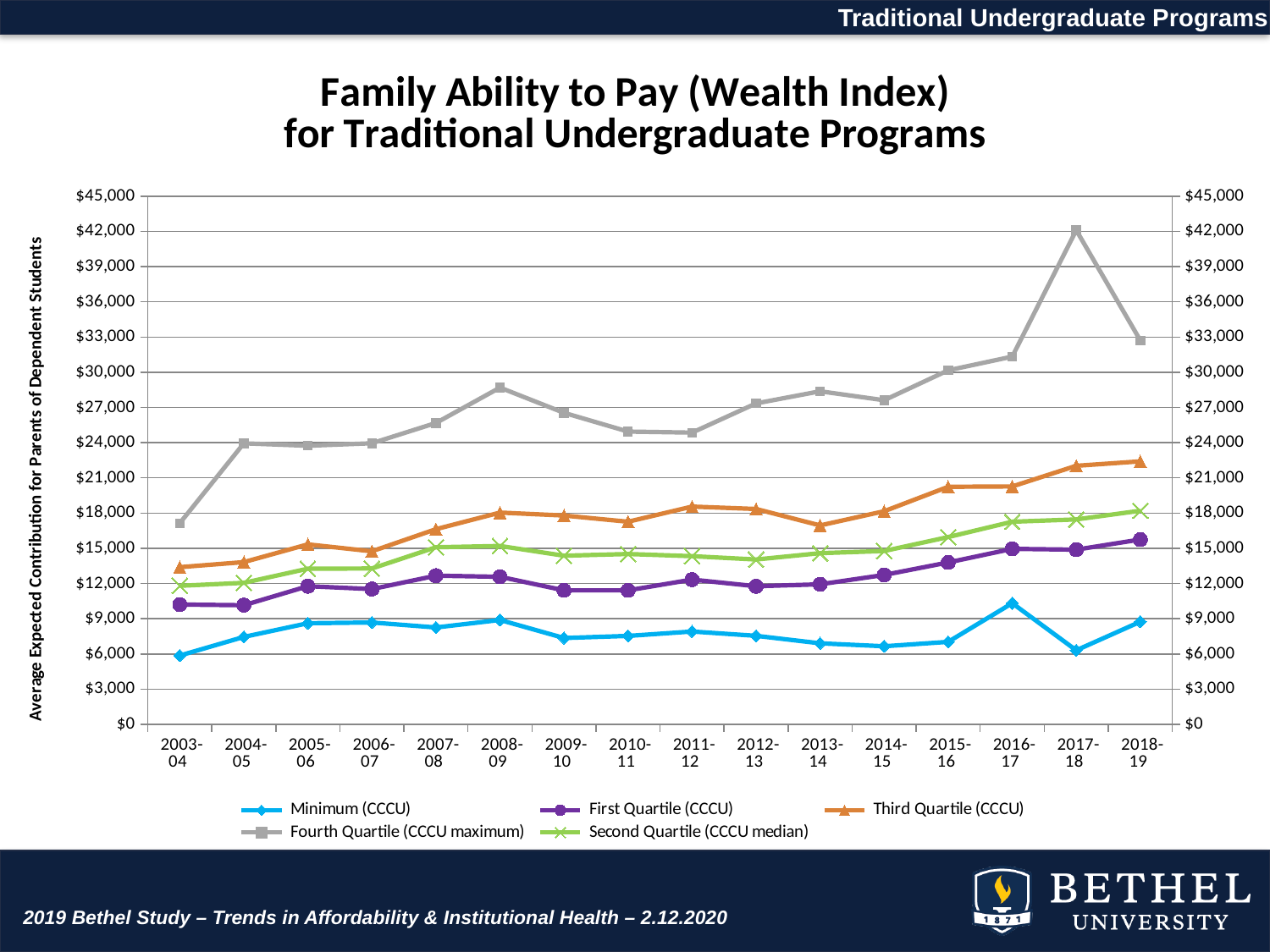
How many series does the legend list? 5 How many academic years are plotted along the x axis? 16 Is the value for Minimum (CCCU) in 2003-04 greater or less than $9,000? less In which year does the Fourth Quartile (CCCU maximum) series reach its highest value? 2017-18 What is the title of the vertical axis? Average Expected Contribution for Parents of Dependent Students What kind of chart is shown on the slide? line chart In which year is the Fourth Quartile (CCCU maximum) series at its lowest value? 2003-04 Is the value for Fourth Quartile (CCCU maximum) in 2017-18 greater or less than $39,000? greater Is the value for Third Quartile (CCCU) in 2018-19 greater or less than $21,000? greater Does the Third Quartile (CCCU) series rise or fall from 2013-14 to 2018-19? rise In which year does the Minimum (CCCU) series reach its highest value? 2016-17 In 2016-17, which is larger: the Minimum (CCCU) value or the First Quartile (CCCU) value? First Quartile (CCCU)